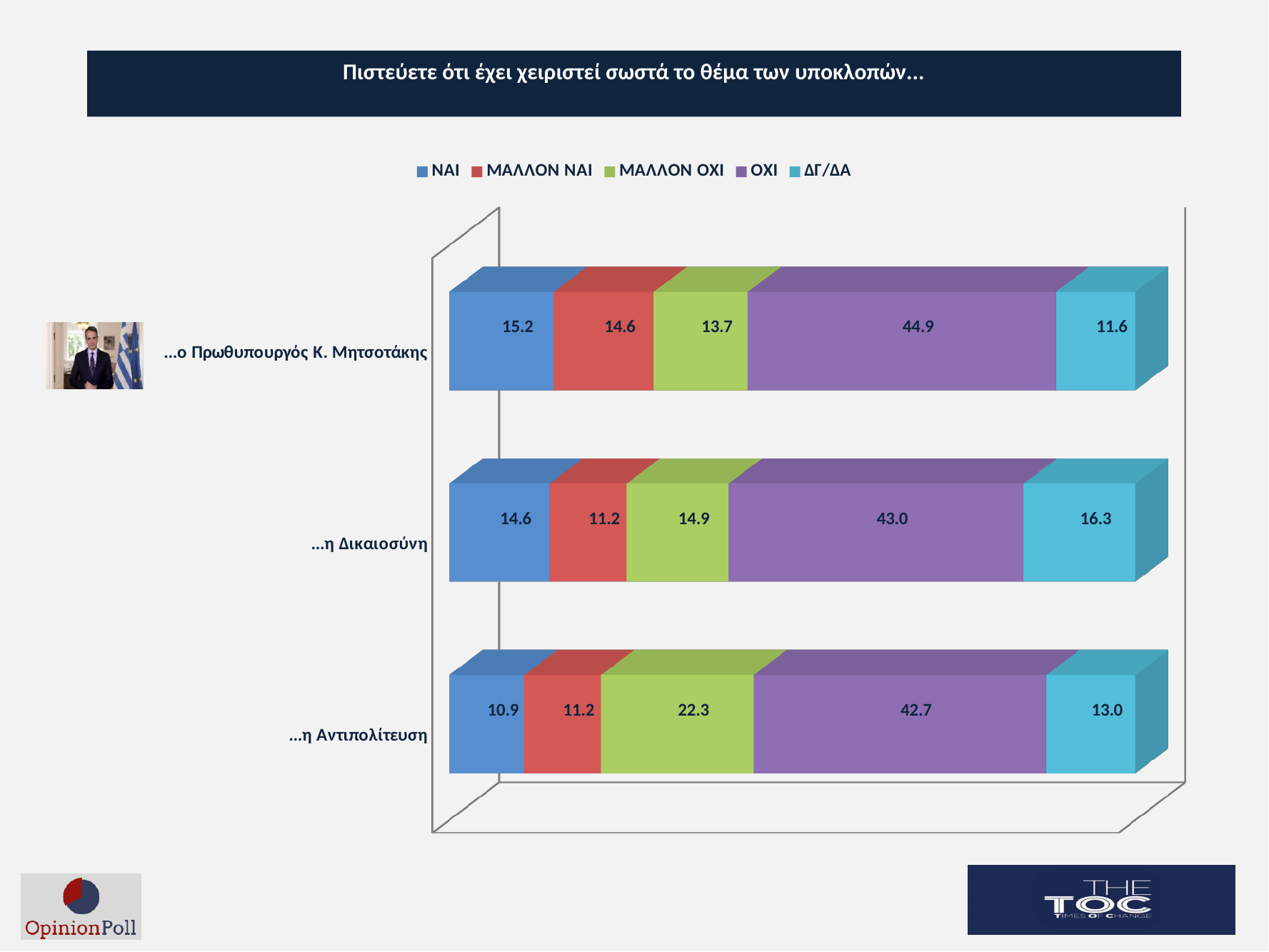
Which is larger: the ΔΓ/ΔΑ value for ...η Δικαιοσύνη or for ...η Αντιπολίτευση? ...η Δικαιοσύνη What is the total of the stacked bar for ...ο Πρωθυπουργός Κ. Μητσοτάκης? 100.0 Which category has the lowest ΝΑΙ value? ...η Αντιπολίτευση How many series does the legend list? 5 Which category has the highest ΟΧΙ value? ...ο Πρωθυπουργός Κ. Μητσοτάκης What is the ΟΧΙ value for ...ο Πρωθυπουργός Κ. Μητσοτάκης? 44.9 What is the ΝΑΙ value for ...η Δικαιοσύνη? 14.6 What kind of chart is shown on the slide? Stacked bar chart What is the difference between the ΜΑΛΛΟΝ ΟΧΙ values for ...η Αντιπολίτευση and ...ο Πρωθυπουργός Κ. Μητσοτάκης? 8.6 How many categories are shown on the chart? 3 What is the ΔΓ/ΔΑ value for ...η Δικαιοσύνη? 16.3 What is the ΜΑΛΛΟΝ ΟΧΙ value for ...η Αντιπολίτευση? 22.3